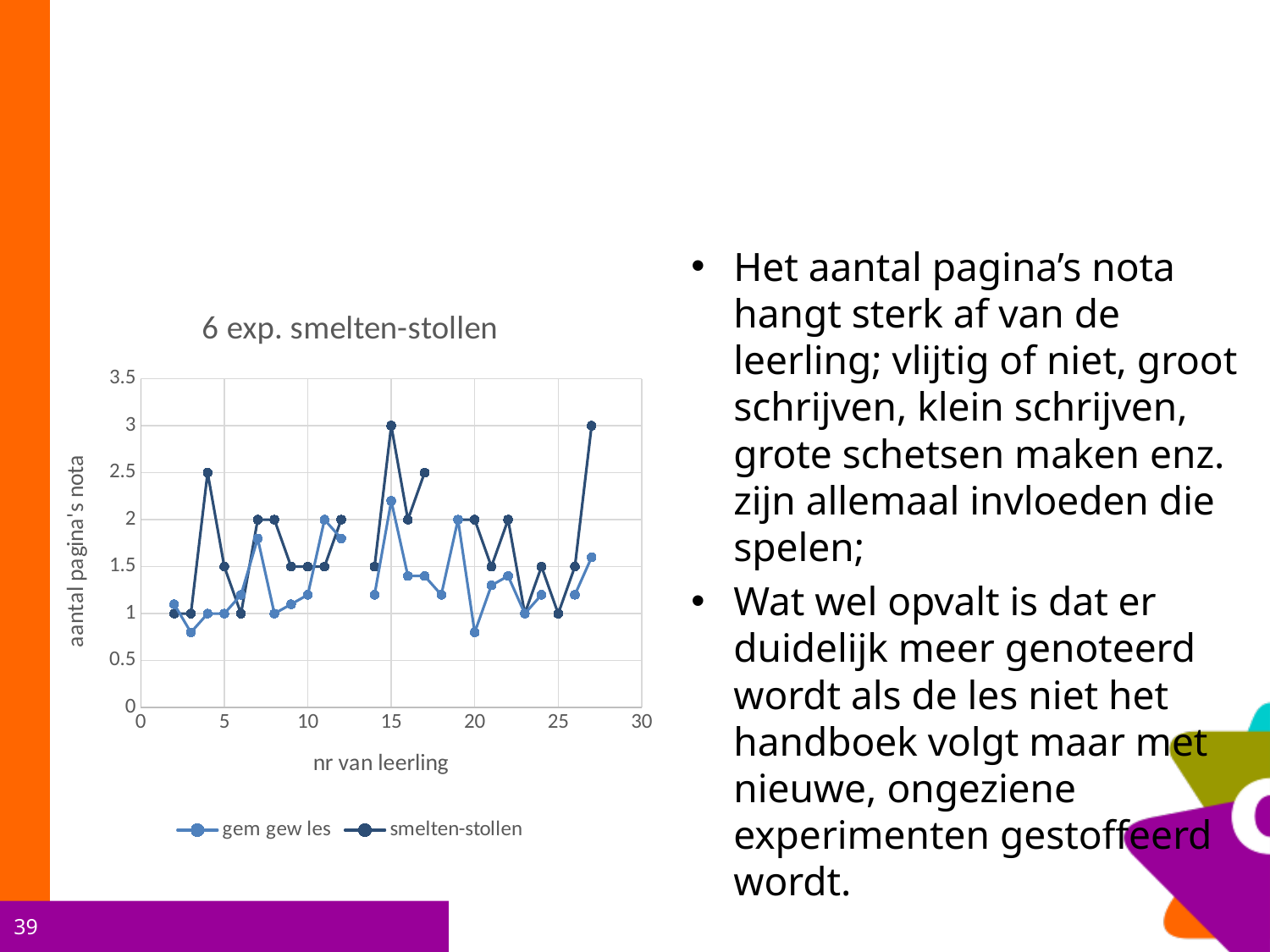
What kind of chart is shown on the slide? line chart What is the title of the chart? 6 exp. smelten-stollen Which series reaches the highest value on the chart? smelten-stollen Is the value of the smelten-stollen series at leerling 4 greater or less than 2? greater At leerling 4, which series has the higher value, gem gew les or smelten-stollen? smelten-stollen What is the label of the x axis? nr van leerling At leerling 15, which series has the higher value, gem gew les or smelten-stollen? smelten-stollen Is the value of the smelten-stollen series at leerling 27 greater or less than 2.5? greater Is the value of the gem gew les series at leerling 20 greater or less than 1? less How many series does the legend list? 2